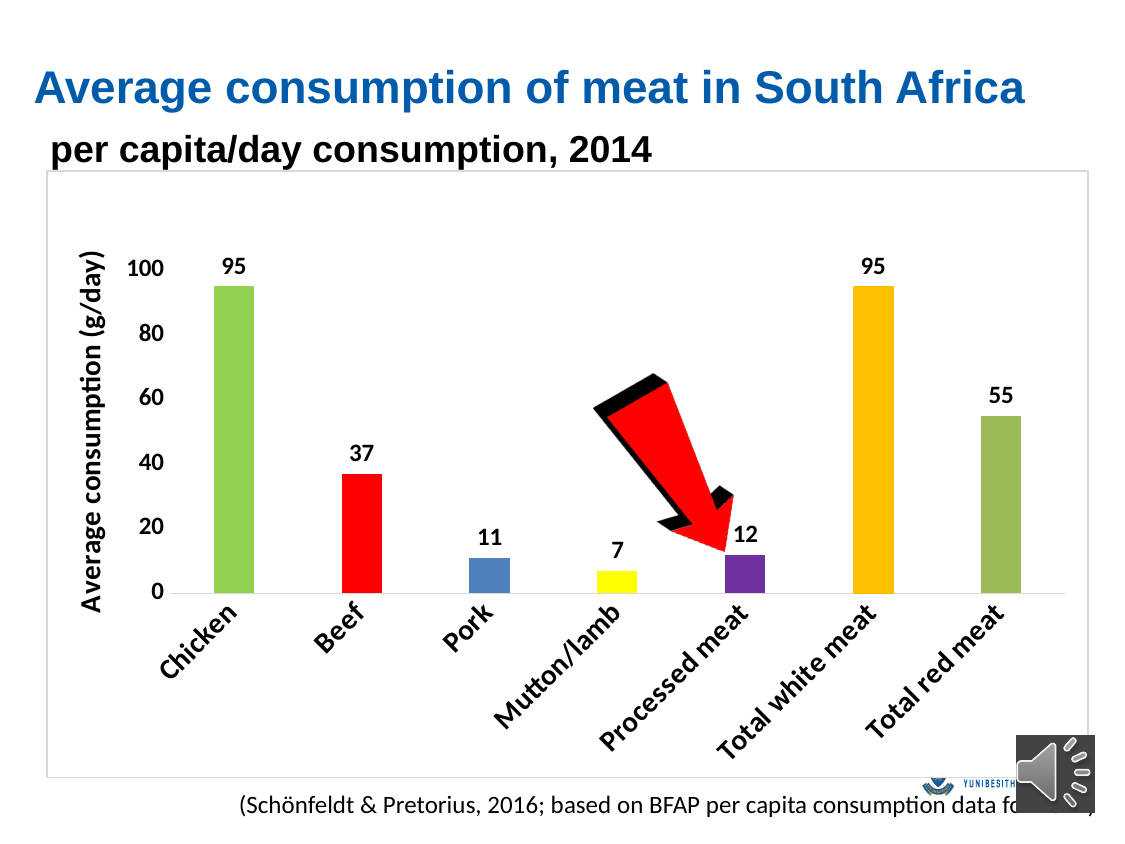
Is the value for Total red meat greater or less than 40? greater What is the average consumption value for Total red meat? 55 Which is larger, the value for Pork or the value for Mutton/lamb? Pork What is the label of the y axis? Average consumption (g/day) How many categories are shown on the x axis? 7 What is the average consumption value for Beef? 37 What is the difference between the values for Total white meat and Total red meat? 40 What is the average consumption value for Processed meat? 12 Which category has the lowest average consumption? Mutton/lamb What is the difference between the values for Beef and Pork? 26 What kind of chart is shown on the slide? bar chart Which category does the red arrow point to? Processed meat